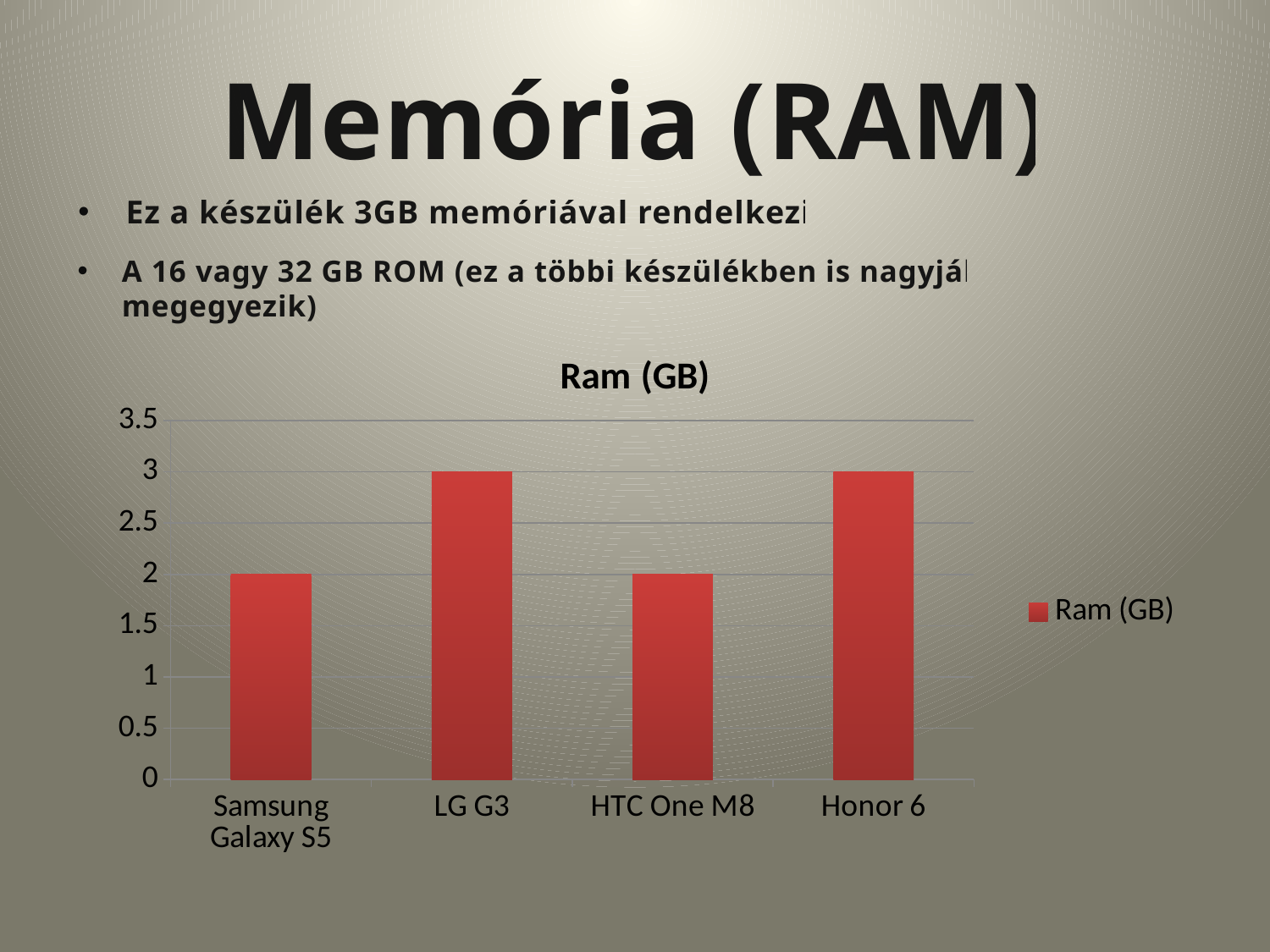
Is the RAM value for the Honor 6 greater or less than 2.5? greater What is the RAM value for the HTC One M8 in the chart? 2 What type of chart is shown on the slide? bar chart How many phone models are shown in the chart? 4 What is the RAM value for the LG G3 in the chart? 3 What is the RAM value for the Samsung Galaxy S5 in the chart? 2 What is the RAM value for the Honor 6 in the chart? 3 Which has more RAM in the chart, the HTC One M8 or the Honor 6? Honor 6 What is the difference in RAM between the LG G3 and the HTC One M8? 1 Which has more RAM in the chart, the LG G3 or the Samsung Galaxy S5? LG G3 Is the RAM value for the Samsung Galaxy S5 greater or less than 2.5? less What is the title of the chart? Ram (GB)